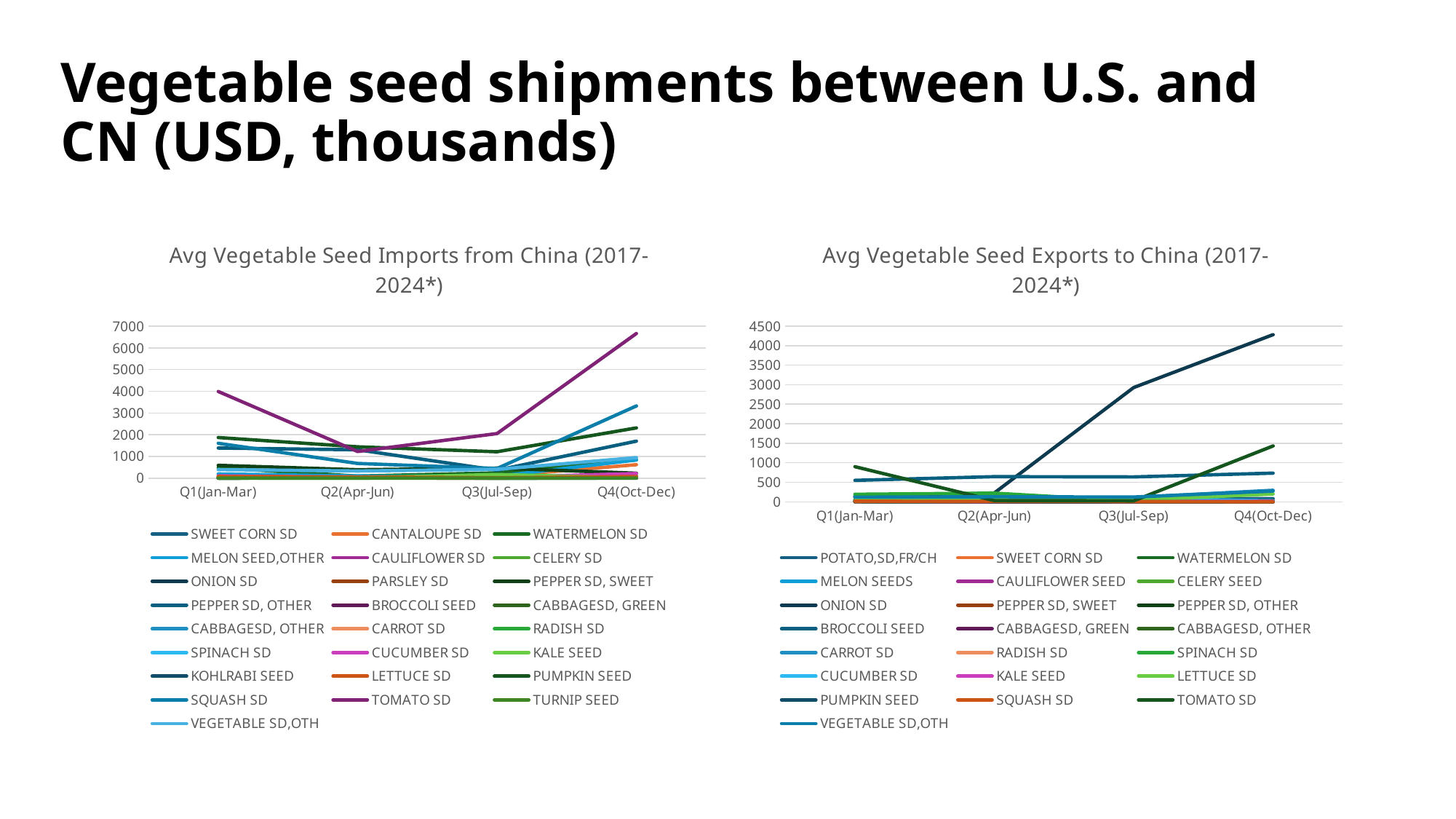
How many quarters are shown on the x axis of the 'Avg Vegetable Seed Imports from China' chart? 4 What kind of chart is the 'Avg Vegetable Seed Exports to China (2017-2024*)' chart? line chart What kind of chart is the 'Avg Vegetable Seed Imports from China (2017-2024*)' chart? line chart In the 'Avg Vegetable Seed Exports to China' chart, is the highest value at Q2(Apr-Jun) greater or less than 1000? less In the 'Avg Vegetable Seed Exports to China' chart, does the topmost line rise or fall from Q2(Apr-Jun) to Q4(Oct-Dec)? rise In the 'Avg Vegetable Seed Imports from China' chart, is the highest value at Q4(Oct-Dec) greater or less than 6000? greater In the 'Avg Vegetable Seed Exports to China' chart, is the highest value at Q4(Oct-Dec) greater or less than 4000? greater How many series does the legend of the 'Avg Vegetable Seed Imports from China' chart list? 25 How many series does the legend of the 'Avg Vegetable Seed Exports to China' chart list? 22 What is the highest value shown on the y axis of the 'Avg Vegetable Seed Imports from China' chart? 7000 In the 'Avg Vegetable Seed Imports from China' chart, does the topmost line rise or fall from Q1(Jan-Mar) to Q2(Apr-Jun)? fall What is the highest value shown on the y axis of the 'Avg Vegetable Seed Exports to China' chart? 4500